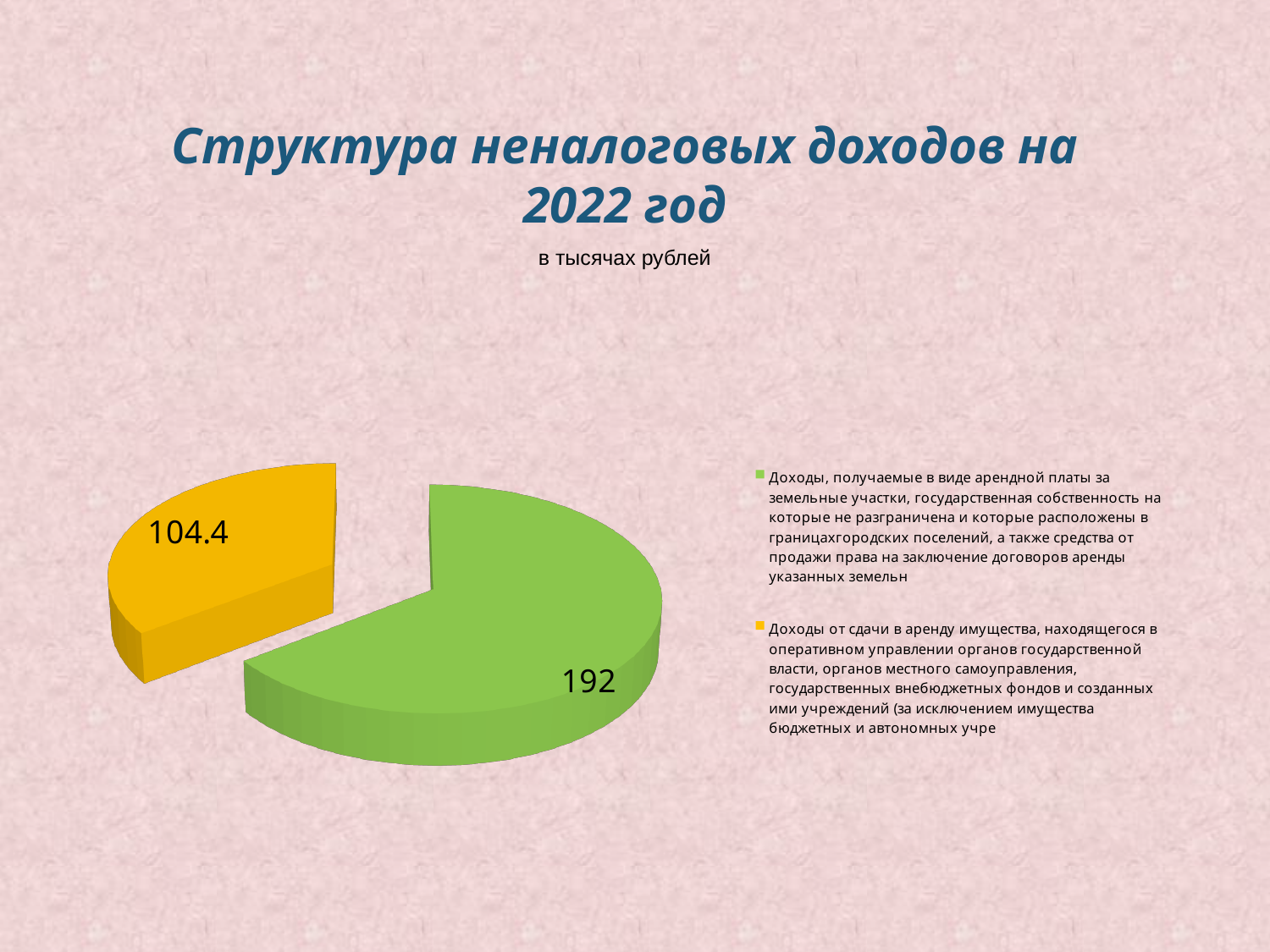
What type of chart is shown on the slide? Pie chart Which is larger: the slice for land plot lease income ("арендной платы за земельные участки") or the slice for property lease income ("сдачи в аренду имущества")? Land plot lease income (192) What share of the pie does the slice labelled 192 represent? 64.8% What is the value of the slice for "Доходы, получаемые в виде арендной платы за земельные участки..."? 192 What is the difference between the two slice values, 192 and 104.4? 87.6 What colour is the slice labelled 104.4? Yellow/orange How many entries does the legend list? 2 What is the total of the two slice values shown on the pie chart? 296.4 Which category has the largest slice of the pie? Доходы, получаемые в виде арендной платы за земельные участки How many slices does the pie chart have? 2 What is the value of the slice for "Доходы от сдачи в аренду имущества, находящегося в оперативном управлении..."? 104.4 Which category has the smallest slice of the pie? Доходы от сдачи в аренду имущества, находящегося в оперативном управлении